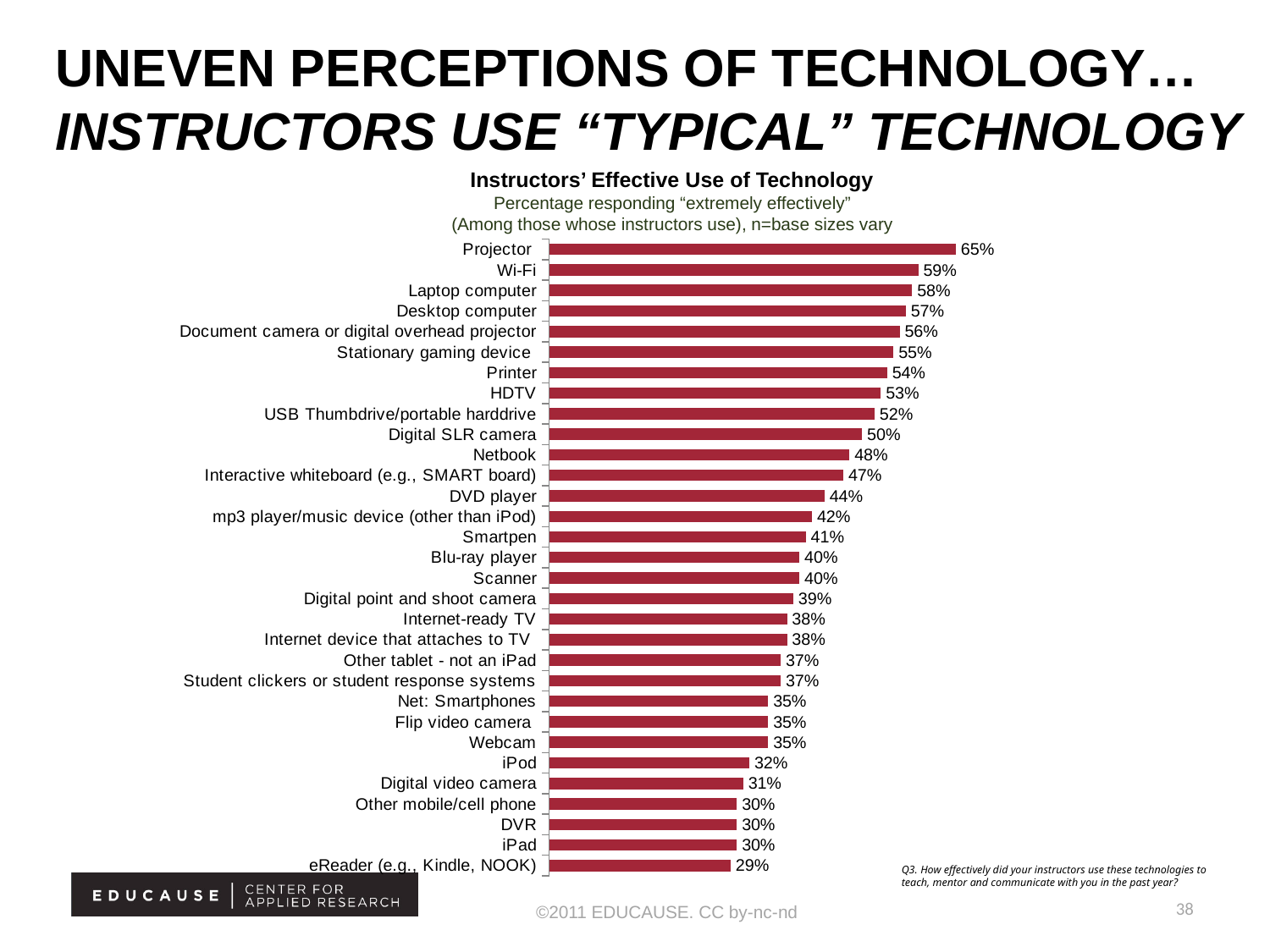
What is the difference between the values for Wi-Fi and Netbook? 11% Which technology has the lowest percentage in the chart? eReader (e.g., Kindle, NOOK) What is the value shown for Interactive whiteboard (e.g., SMART board)? 47% How many technologies are listed in the chart? 31 What percentage of respondents said instructors use the Projector extremely effectively? 65% What is the title of the chart? Instructors' Effective Use of Technology Which has a higher value, Webcam or Smartpen? Smartpen What is the value shown for iPad? 30% Which has a higher value, HDTV or DVD player? HDTV What type of chart is shown on the slide? Bar chart Which technology has the highest percentage in the chart? Projector What is the difference between the values for Projector and eReader (e.g., Kindle, NOOK)? 36%